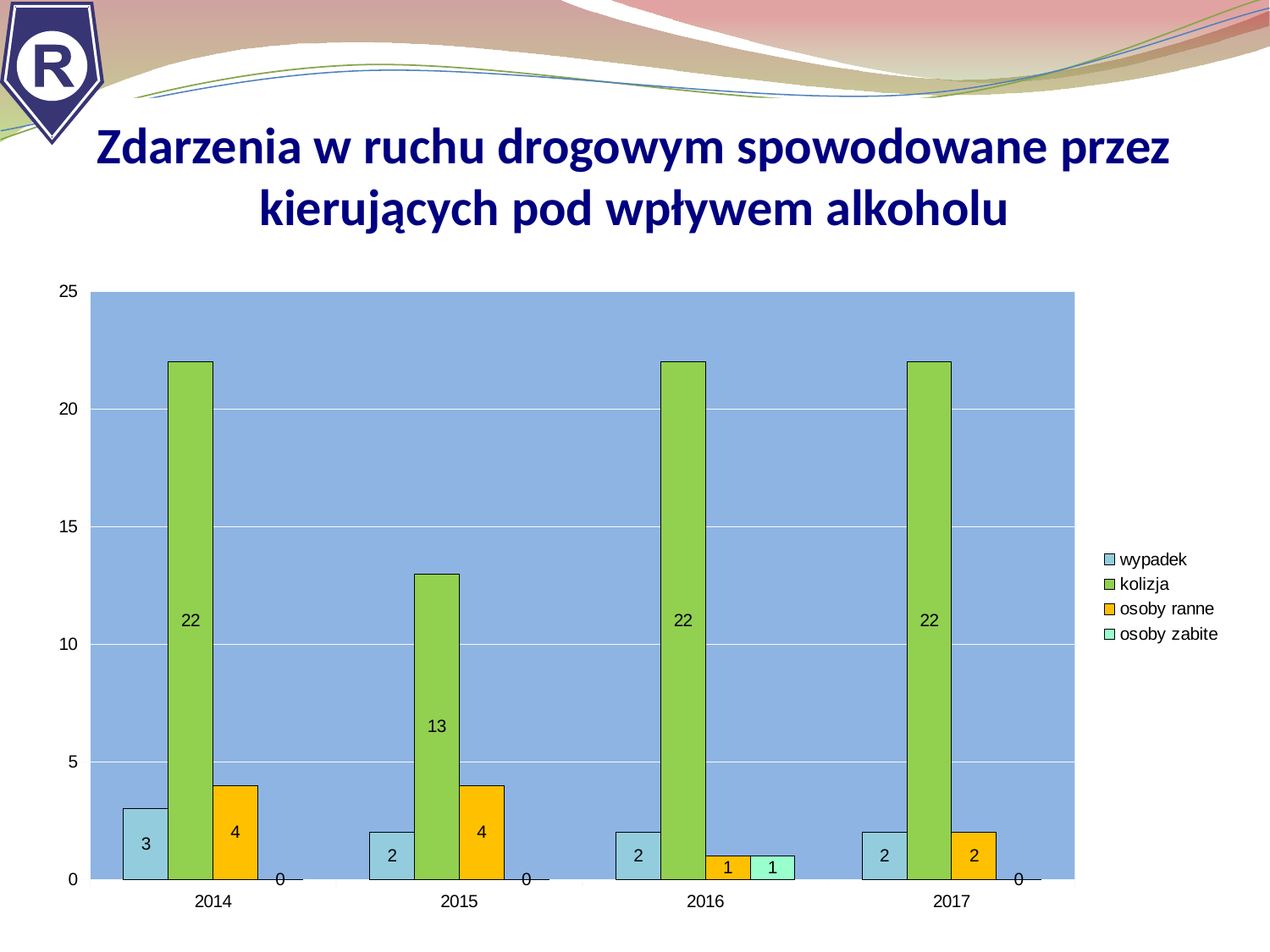
How many series does the legend list? 4 What is the difference between the kolizja values for 2014 and 2015? 9 What is the value for wypadek in 2014? 3 What is the value for osoby zabite in 2016? 1 Which is larger: osoby ranne in 2015 or osoby ranne in 2017? osoby ranne in 2015 How many years are shown on the x axis? 4 What kind of chart is shown on the slide? bar chart Which series is shown in green in the legend? kolizja In which year is the wypadek value highest? 2014 In which year is the kolizja value lowest? 2015 What is the value for kolizja in 2015? 13 What is the value for osoby ranne in 2017? 2